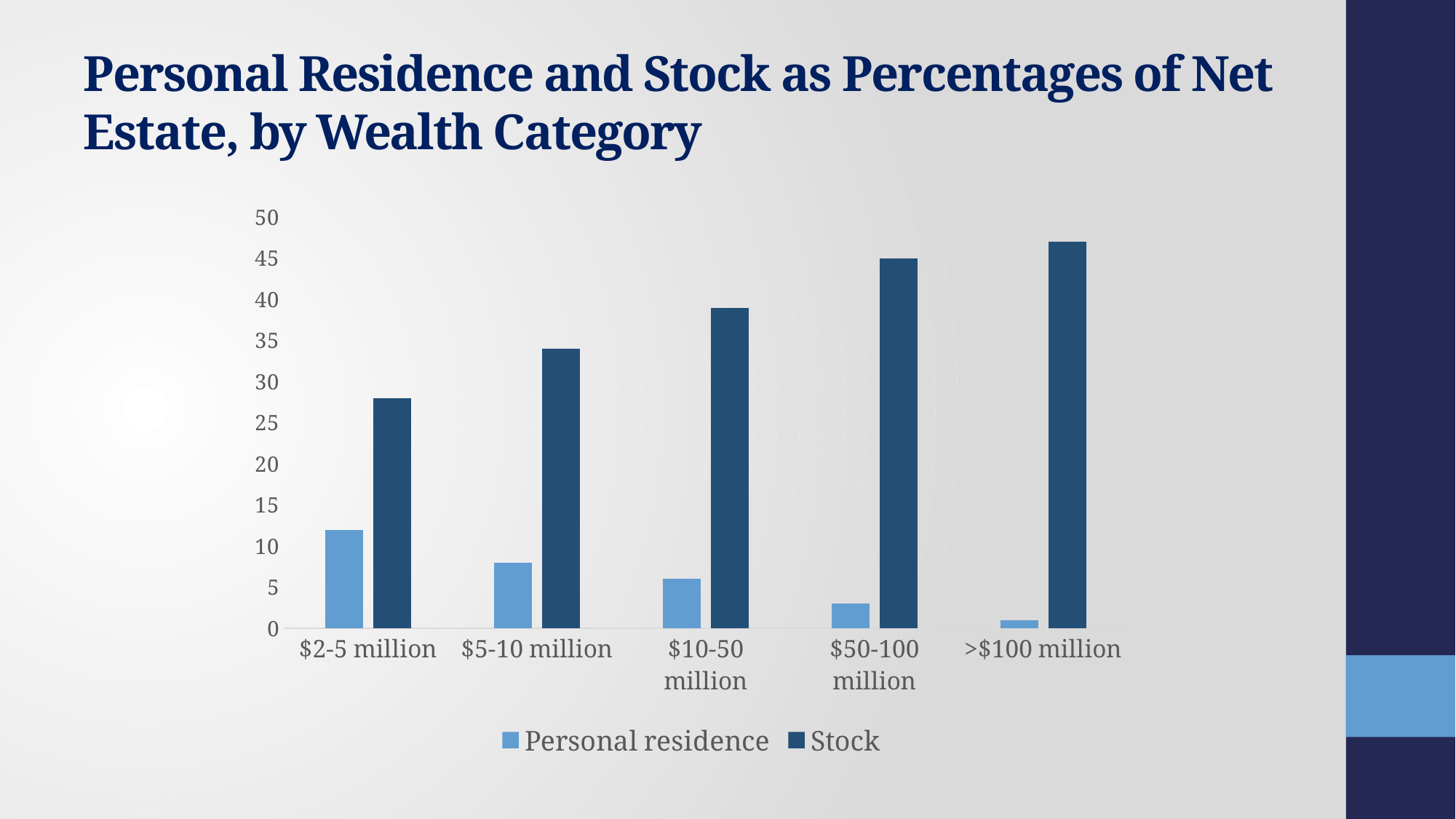
How many wealth categories are shown on the x axis? 5 Which wealth category has the highest Stock value? >$100 million What kind of chart is shown on the slide? bar chart Is the Stock value for $2-5 million greater or less than 30? less How many series does the legend list? 2 Which wealth category has the highest Personal residence value? $2-5 million Is the Stock value for >$100 million greater or less than 40? greater Is the Stock value for $10-50 million greater or less than 35? greater Which wealth category has the lowest Personal residence value? >$100 million Which is larger for the $5-10 million category, Personal residence or Stock? Stock Do the Stock values rise or fall as the wealth category increases along the x axis? rise